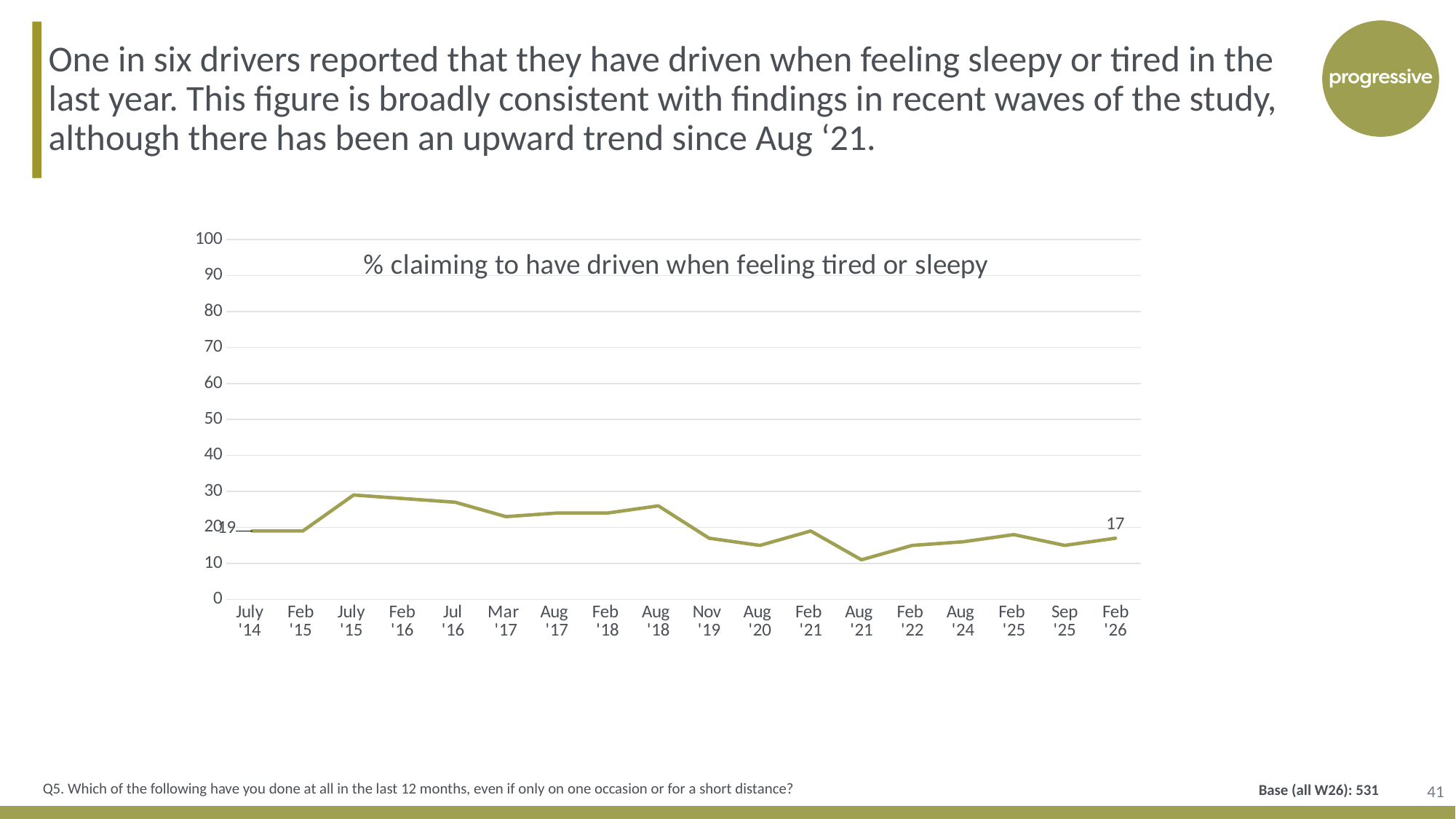
What is the value for July '14? 19 Which is larger, the value for Aug '18 or the value for Nov '19? Aug '18 What is the difference between the values for July '14 and Feb '26? 2 What kind of chart is shown on the slide? line chart Do the values rise or fall between Aug '18 and Aug '21? fall Which time point has the highest value? July '15 What is the title of the chart? % claiming to have driven when feeling tired or sleepy What is the value for Feb '26? 17 How many time points are plotted on the x axis? 18 Is the value for July '15 greater or less than 20? greater Which time point has the lowest value? Aug '21 Is the value for Aug '21 greater or less than 20? less